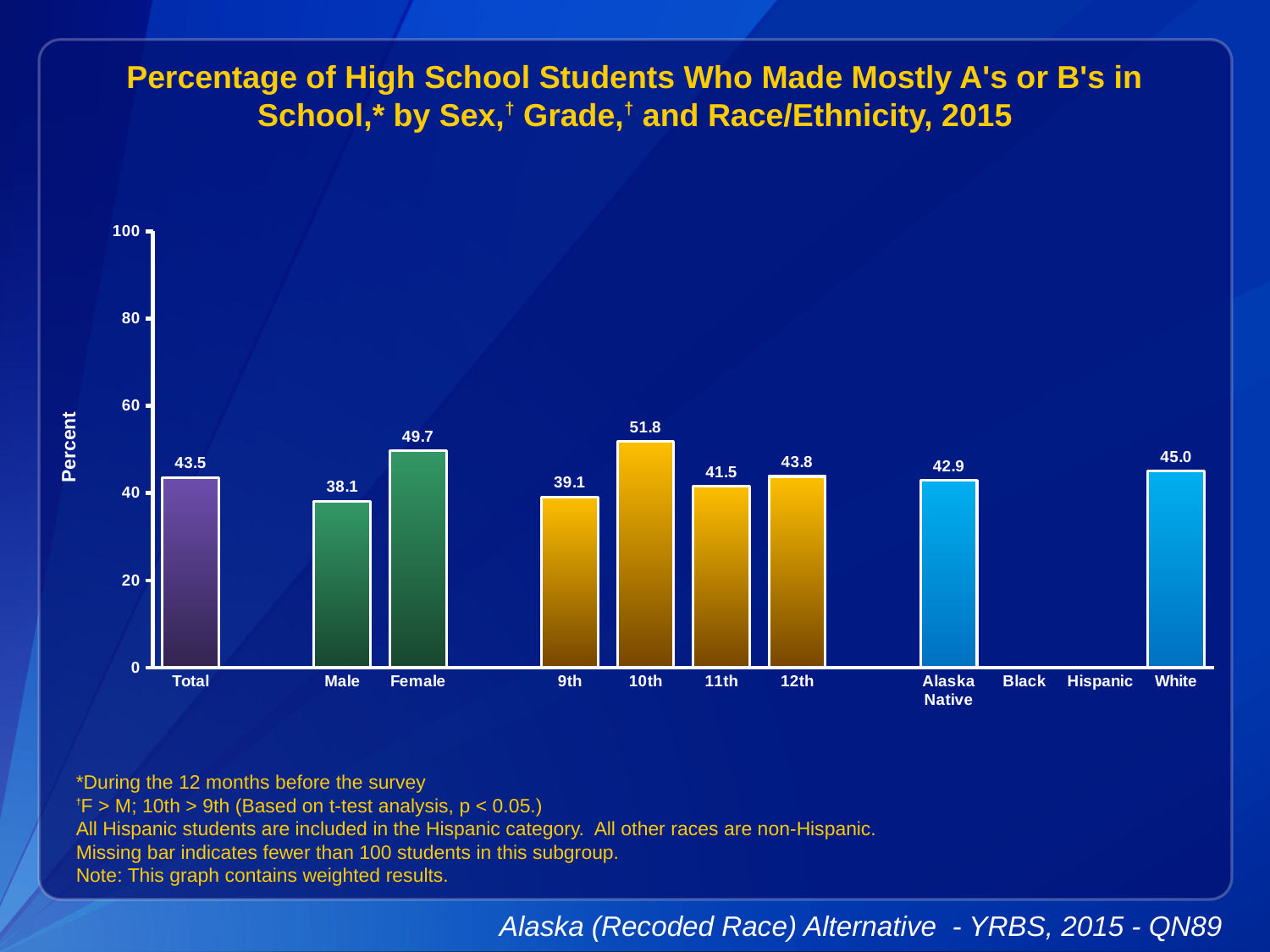
Is the value for White greater or less than 40? greater What is the label of the y axis? Percent What is the value for Alaska Native? 42.9 Which is larger, the value for 12th grade or the value for 9th grade? 12th What is the value for Female? 49.7 Which category has the lowest value? Male What kind of chart is shown? bar chart What is the difference between the Female and Male values? 11.6 How many bars are plotted on the chart? 9 What is the value for Total? 43.5 Which category has the highest value? 10th What is the value for 10th grade? 51.8